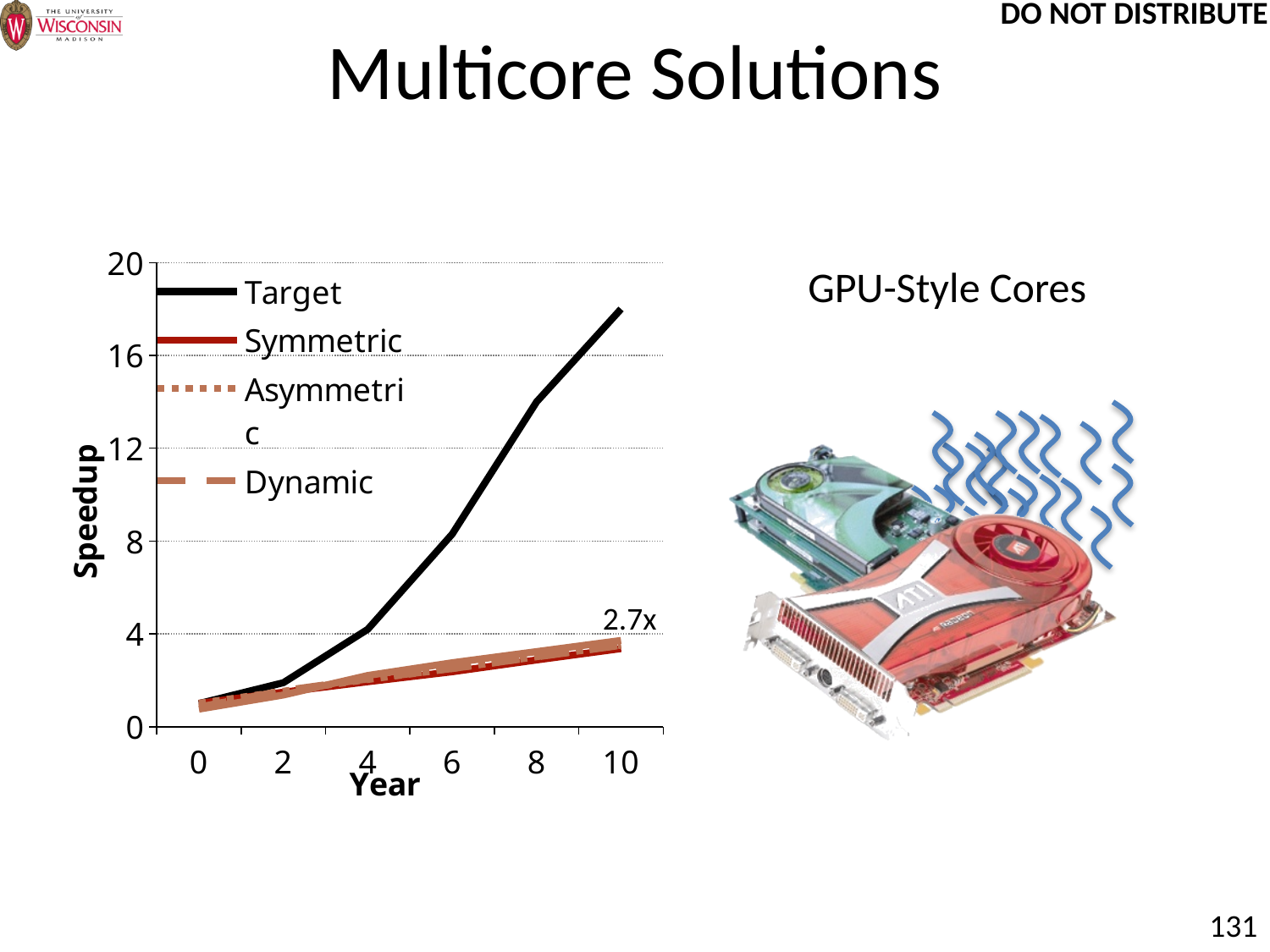
Does the Target series rise or fall as the year increases? rise Is the Target speedup at year 10 greater or less than 16? greater What is the highest value shown on the chart's y axis? 20 Is the Target speedup at year 8 greater or less than 12? greater What are the four series named in the chart's legend? Target, Symmetric, Asymmetric, Dynamic Is the Target speedup at year 2 greater or less than 4? less Which series has the highest speedup at year 10? Target What kind of chart is shown on the slide? line chart At year 10, which is larger, the Target speedup or the Dynamic speedup? Target How many series does the chart's legend list? 4 What is the label on the chart's y axis? Speedup